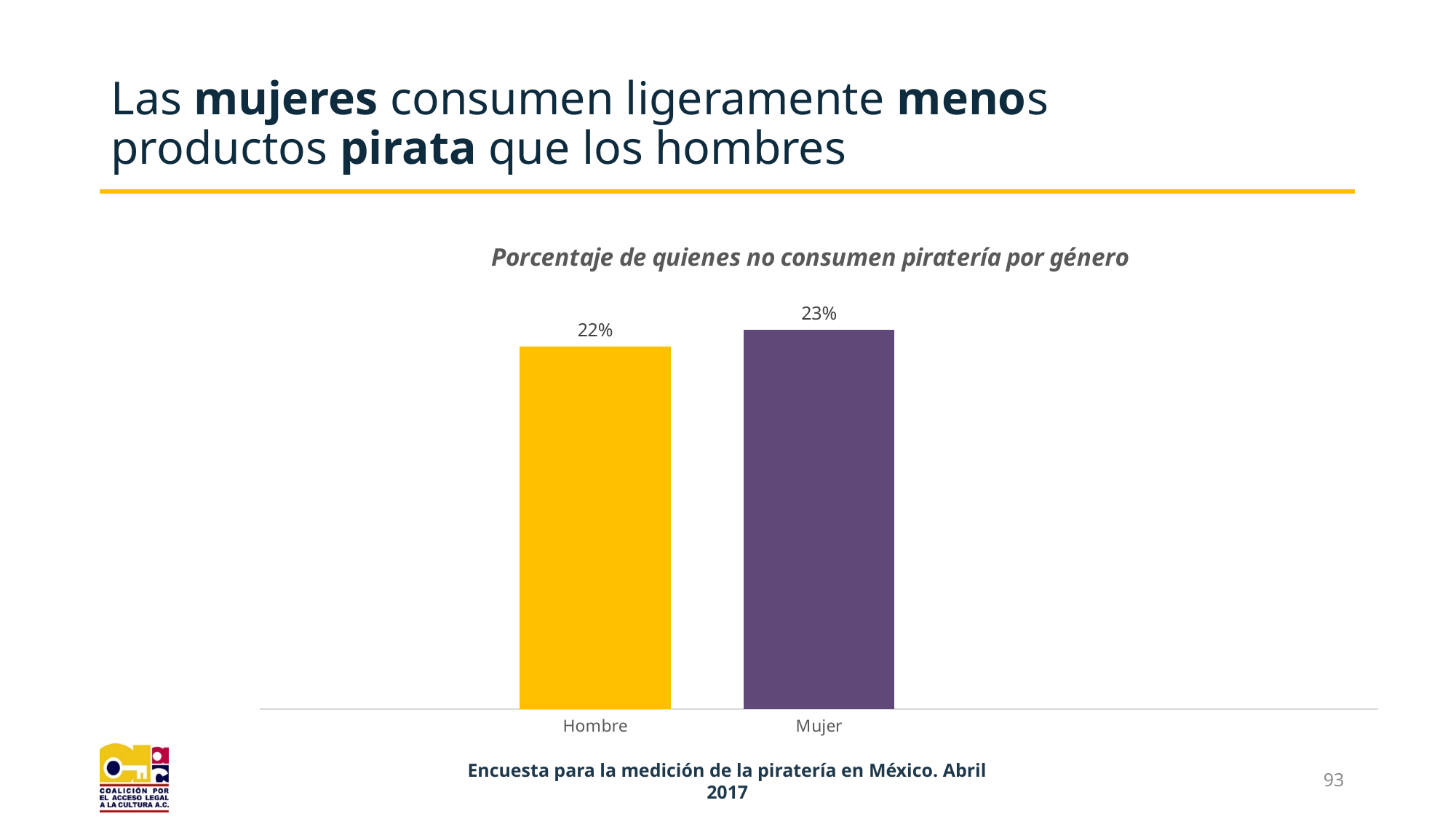
How many categories are shown in the chart? 2 What colour is the bar for Hombre? Yellow Which is larger, the value for Hombre or the value for Mujer? Mujer What is the value for Hombre? 22% What is the difference between the values for Mujer and Hombre? 1% What kind of chart is shown on the slide? Bar chart Which category has the lowest value? Hombre Which category has the highest value? Mujer What is the title of the chart? Porcentaje de quienes no consumen piratería por género What is the value for Mujer? 23%